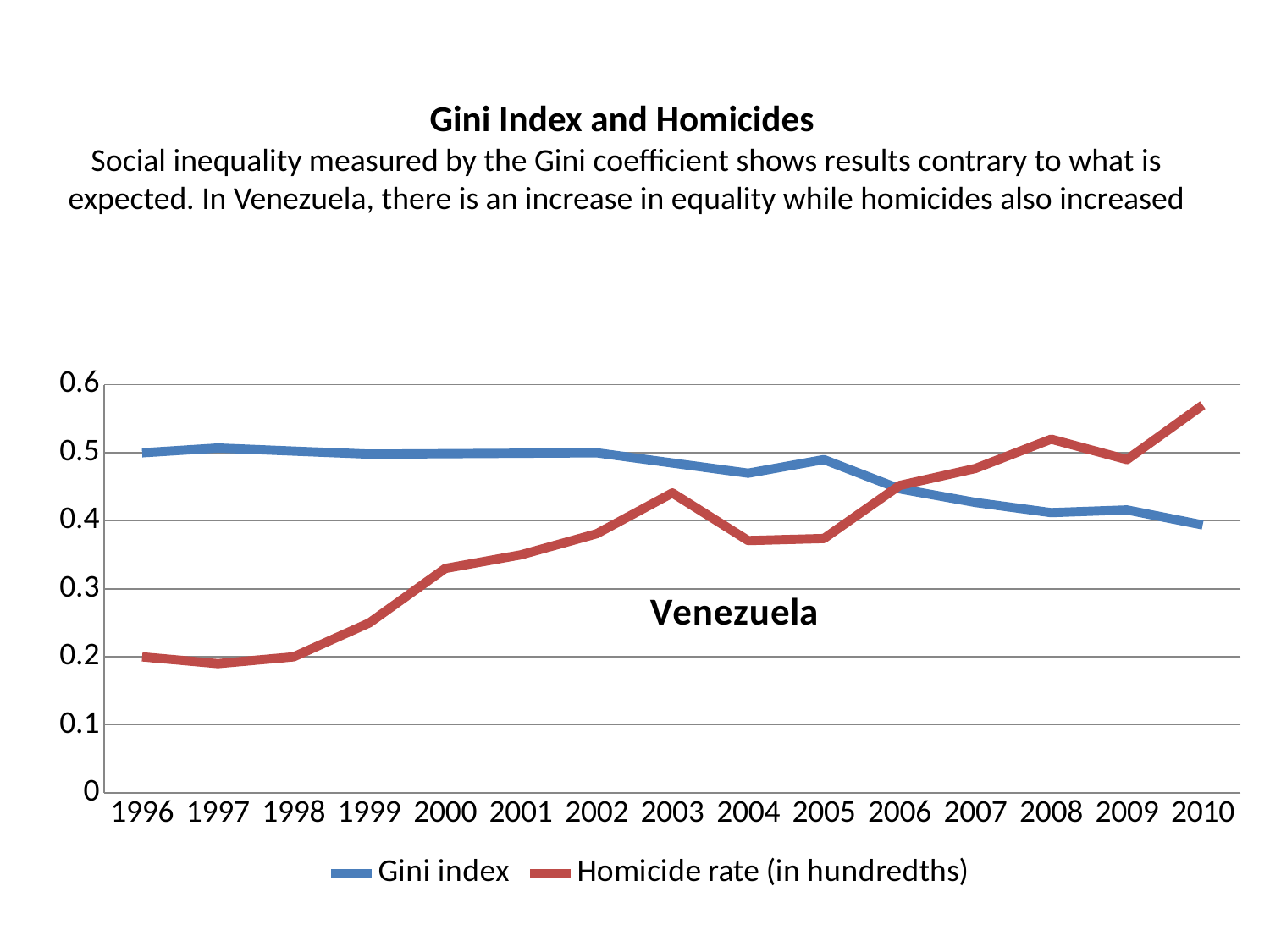
What is the title of the chart? Venezuela In which year is the Homicide rate (in hundredths) highest? 2010 In 1996, which is larger: the Gini index or the Homicide rate (in hundredths)? Gini index What kind of chart is shown on the slide? line chart How many years are plotted along the x axis? 15 Does the Gini index rise or fall from 1996 to 2010? fall Is the Homicide rate (in hundredths) for 2010 greater or less than 0.5? greater Is the Homicide rate (in hundredths) for 1996 greater or less than 0.3? less In which year is the Gini index lowest? 2010 Is the Gini index for 2006 greater or less than 0.5? less Does the Homicide rate (in hundredths) rise or fall from 1996 to 2010? rise How many series does the legend list? 2